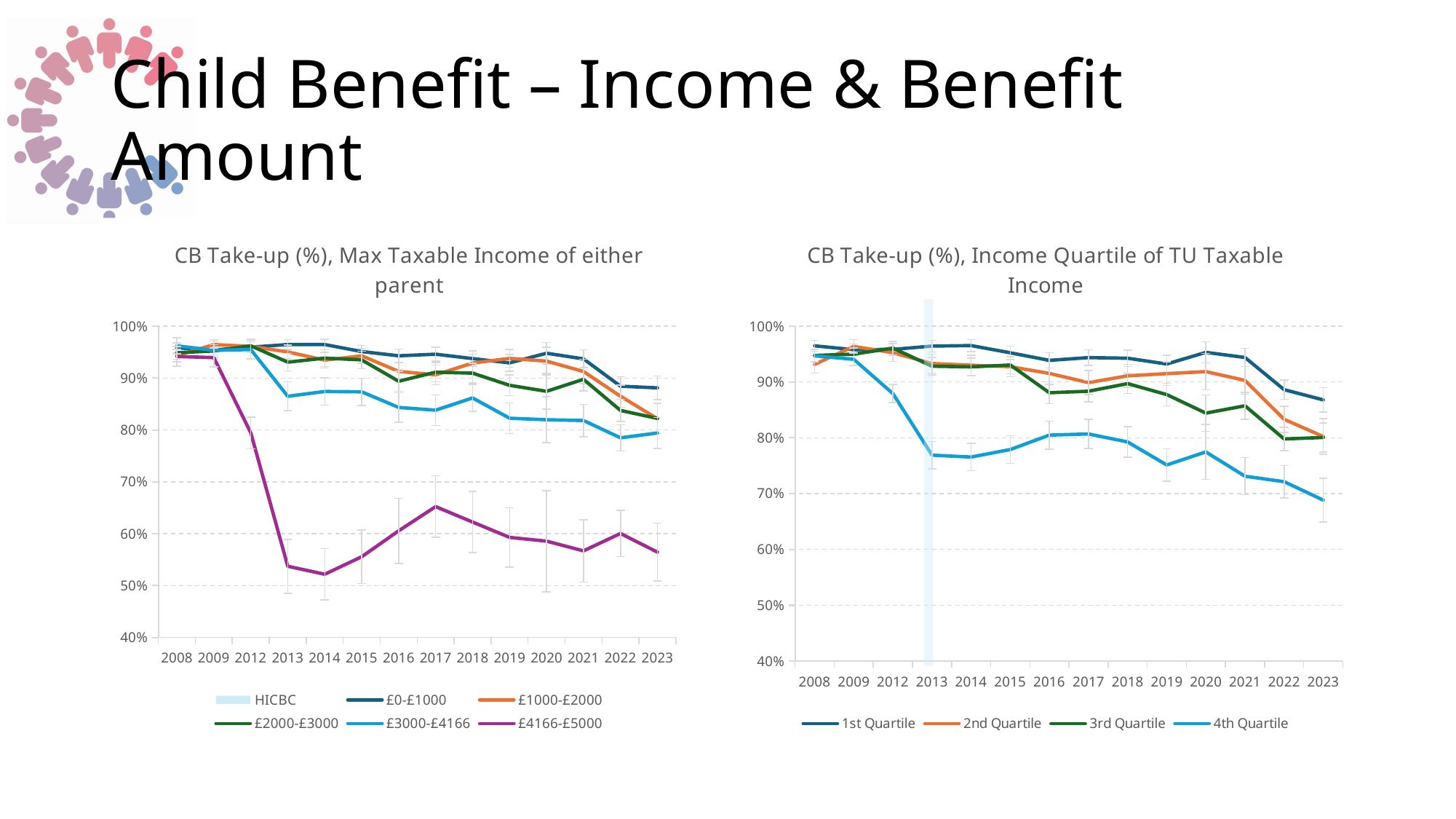
In the right chart, 'CB Take-up (%), Income Quartile of TU Taxable Income', how many years are shown on the x axis? 14 In the right chart, does the 4th Quartile series generally rise or fall from 2008 to 2023? fall In the right chart, 'CB Take-up (%), Income Quartile of TU Taxable Income', how many series does the legend list? 4 In the right chart, is the value for 4th Quartile in 2023 greater or less than 70%? less In the left chart, 'CB Take-up (%), Max Taxable Income of either parent', how many entries does the legend list? 6 In the left chart, which is larger in 2014: £3000-£4166 or £4166-£5000? £3000-£4166 In the left chart, is the value for £4166-£5000 in 2014 greater or less than 60%? less What kind of chart is the left chart, 'CB Take-up (%), Max Taxable Income of either parent'? line chart In the left chart, which series has the lowest value in 2023? £4166-£5000 In the right chart, is the value for 1st Quartile in 2023 greater or less than 80%? greater In the right chart, which series has the highest value in 2023? 1st Quartile